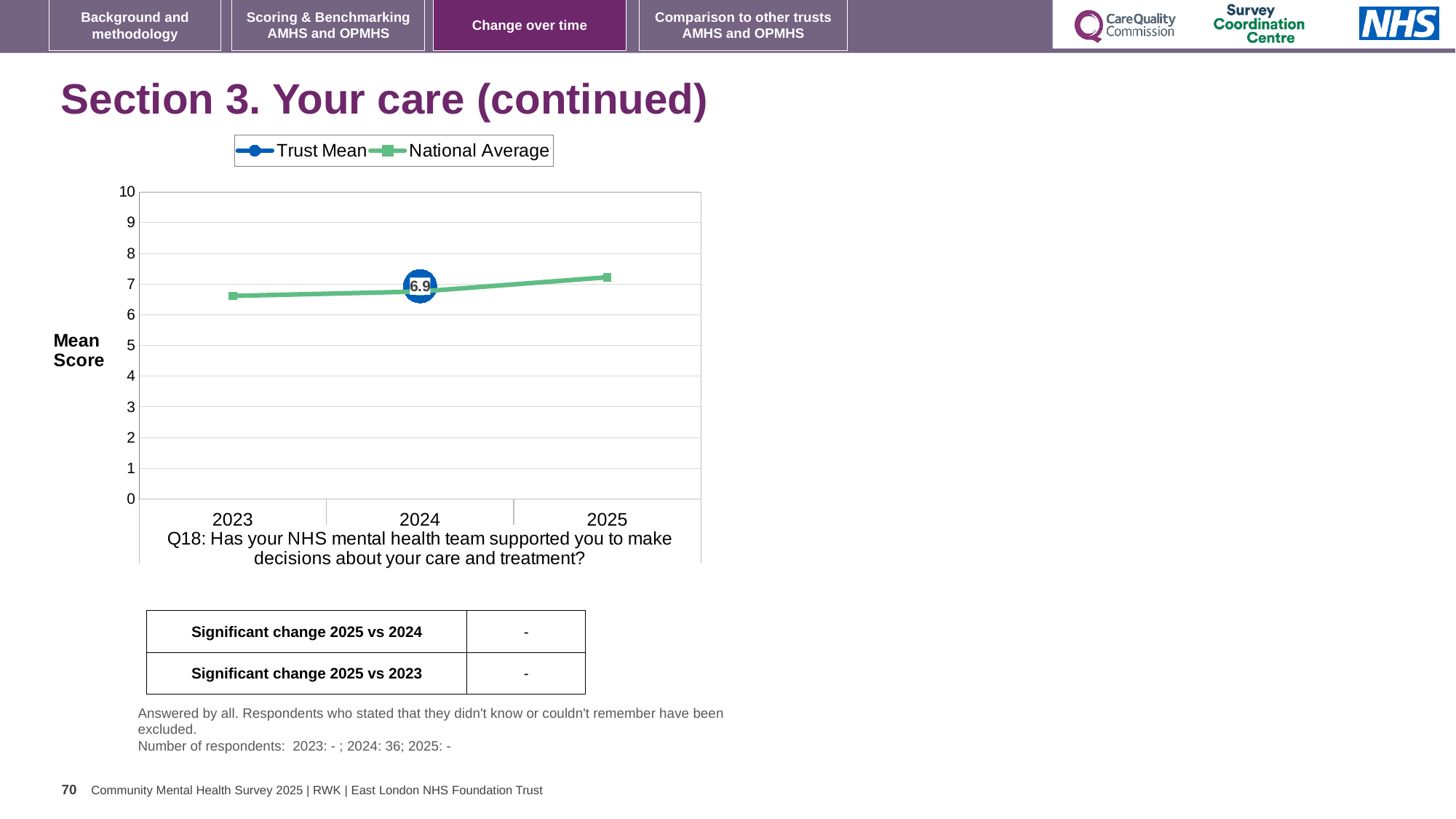
What is the label on the y axis of the chart? Mean Score Which year has the lowest National Average? 2023 Is the National Average value for 2025 greater or less than 5? greater Which is larger, the National Average for 2025 or for 2023? 2025 Is the National Average value for 2023 greater or less than 7? less How many years are shown on the x axis? 3 Does the National Average rise or fall from 2023 to 2025? Rise What kind of chart is shown on the slide? Line chart How many series does the legend list? 2 What is the Trust Mean value for 2024? 6.9 Which year has the highest National Average? 2025 For how many years is a Trust Mean point plotted? 1